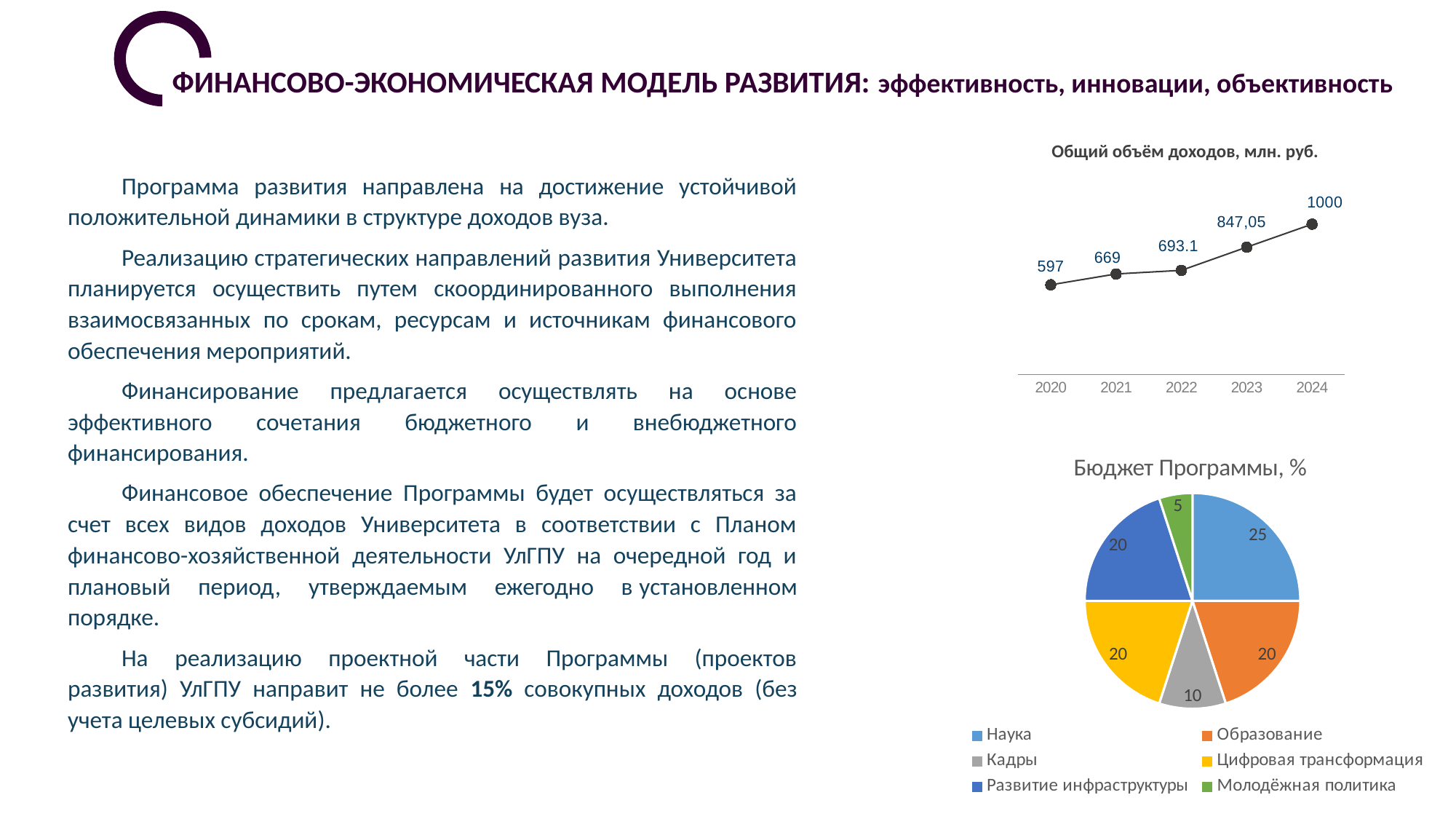
In the chart 'Общий объём доходов, млн. руб.', do the values rise or fall from 2020 to 2024? rise In the chart 'Общий объём доходов, млн. руб.', which year has the lowest value? 2020 In the pie chart 'Бюджет Программы, %', what is the value for Наука? 25 In the chart 'Общий объём доходов, млн. руб.', which year has the highest value? 2024 In the chart 'Общий объём доходов, млн. руб.', what is the value for 2023? 847,05 In the chart 'Общий объём доходов, млн. руб.', how many years are plotted? 5 What kind of chart is 'Общий объём доходов, млн. руб.'? line chart In the pie chart 'Бюджет Программы, %', which category has the largest slice? Наука How many categories does the legend of the pie chart 'Бюджет Программы, %' list? 6 In the chart 'Общий объём доходов, млн. руб.', what is the value for 2020? 597 In the chart 'Общий объём доходов, млн. руб.', what is the difference between the values for 2021 and 2020? 72 In the pie chart 'Бюджет Программы, %', what is the value for Молодёжная политика? 5